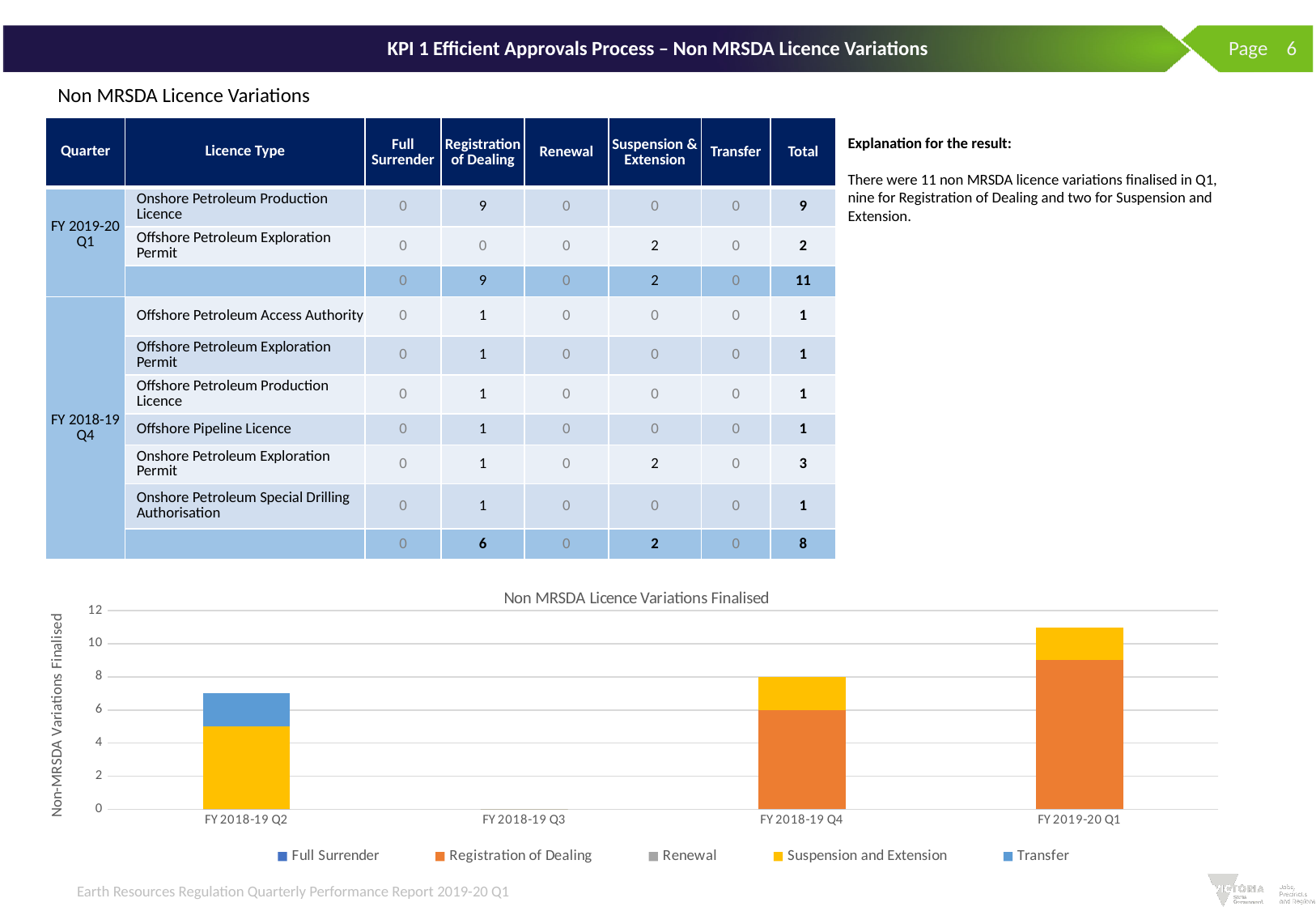
What is the total height of the stacked bar for FY 2018-19 Q4? 8 Which quarter has the highest total of non-MRSDA variations finalised in the chart? FY 2019-20 Q1 What is the value for Registration of Dealing in FY 2018-19 Q4? 6 How many quarters are shown on the x axis of the chart? 4 What is the title of the chart? Non MRSDA Licence Variations Finalised How many series does the chart legend list? 5 Is the value for Registration of Dealing in FY 2019-20 Q1 greater or less than 8? greater Which quarter has a larger total, FY 2018-19 Q4 or FY 2019-20 Q1? FY 2019-20 Q1 Is the total for FY 2019-20 Q1 greater or less than 10? greater Which quarter has the lowest total of non-MRSDA variations finalised in the chart? FY 2018-19 Q3 What kind of chart is shown on the slide? Stacked bar chart Which series is shown in orange in the chart? Registration of Dealing